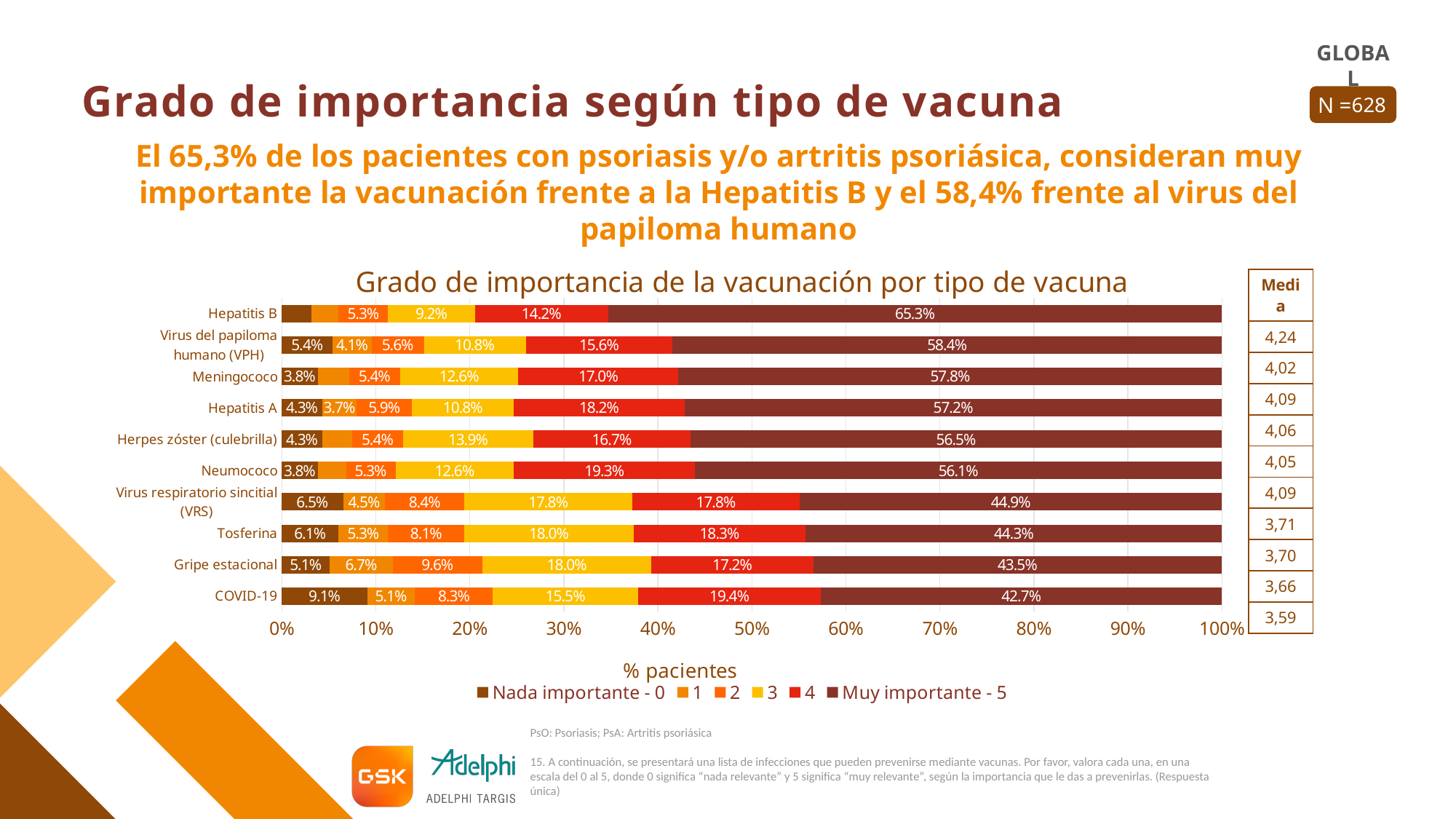
What is the value of the 'Nada importante - 0' segment for COVID-19? 9.1% Which has a larger 'Muy importante - 5' percentage, Tosferina or Gripe estacional? Tosferina What percentage of patients rated Hepatitis B vaccination as 'Muy importante - 5'? 65.3% How many series does the legend list? 6 Which vaccine has the highest 'Muy importante - 5' percentage? Hepatitis B What is the title of the x axis of the chart? % pacientes What type of chart is shown on the slide? Stacked bar chart What is the difference in 'Muy importante - 5' percentage between Hepatitis B and Virus del papiloma humano (VPH)? 6.9 percentage points What percentage of patients rated COVID-19 vaccination as 'Muy importante - 5'? 42.7% How many vaccine types are shown in the chart? 10 What is the value of the '4' segment for COVID-19? 19.4% Which vaccine has the lowest 'Muy importante - 5' percentage? COVID-19